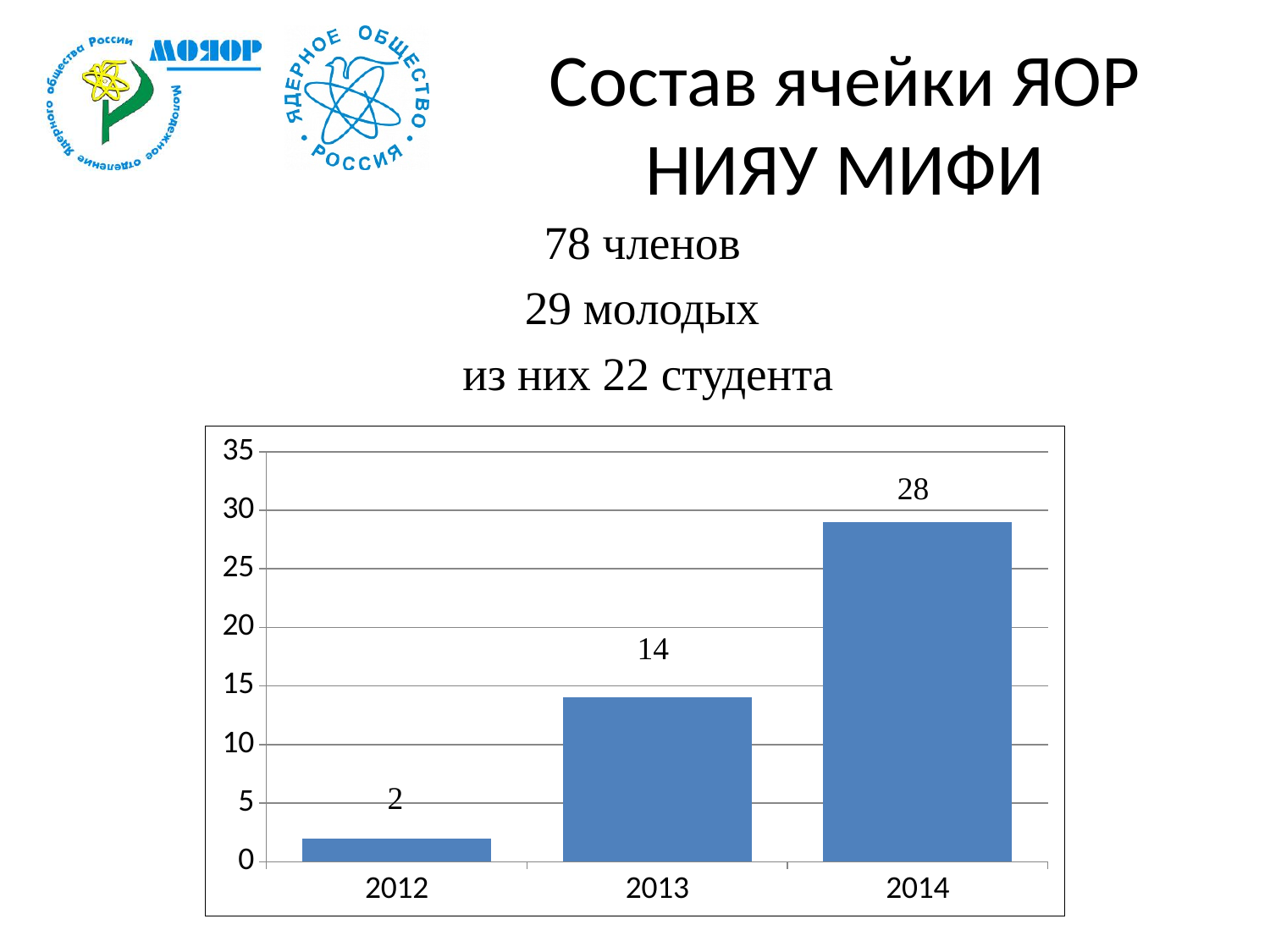
What is the difference between the values for 2013 and 2012? 12 Which year has the highest value? 2014 How many years are shown on the x axis of the chart? 3 What is the difference between the values for 2014 and 2013? 14 Is the value for 2014 greater or less than 25? greater What is the value for 2012? 2 Which is larger, the value for 2013 or the value for 2014? 2014 What is the value for 2013? 14 Do the values rise or fall from 2012 to 2014? rise What is the value for 2014? 28 What kind of chart is shown on the slide? bar chart Which year has the lowest value? 2012